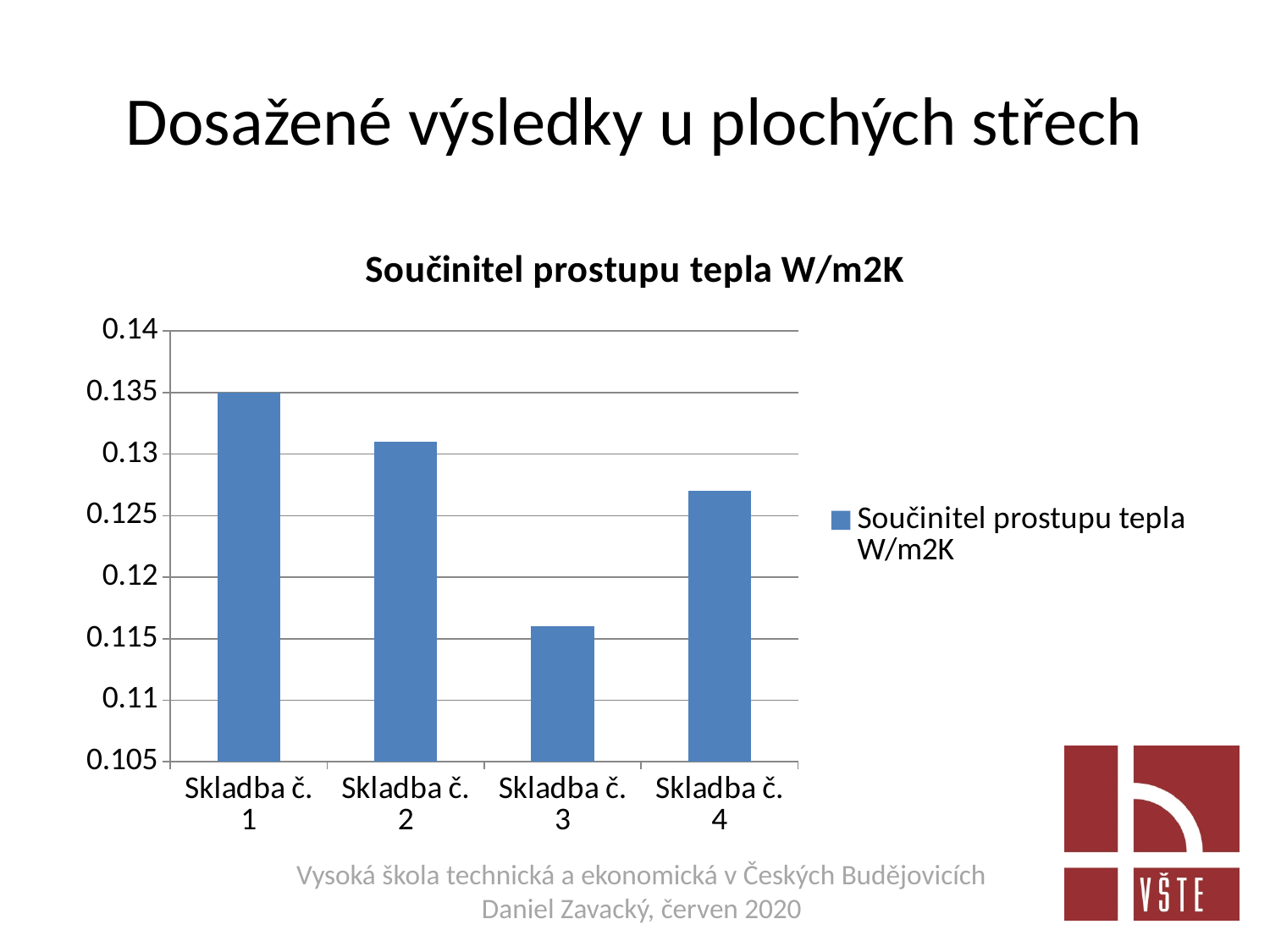
How many categories (skladby) are shown on the x axis of the chart? 4 Which category has the highest value in the chart? Skladba č. 1 How many series does the chart legend list? 1 Which has a larger value, Skladba č. 2 or Skladba č. 4? Skladba č. 2 Which has a larger value, Skladba č. 3 or Skladba č. 4? Skladba č. 4 Which category has the lowest value in the chart? Skladba č. 3 Is the value for Skladba č. 1 greater or less than 0.13? greater Do the values fall or rise from Skladba č. 1 to Skladba č. 3? fall Is the value for Skladba č. 3 greater or less than 0.12? less What type of chart is shown on the slide? bar chart What is the title of the chart? Součinitel prostupu tepla W/m2K Is the value for Skladba č. 4 greater or less than 0.125? greater